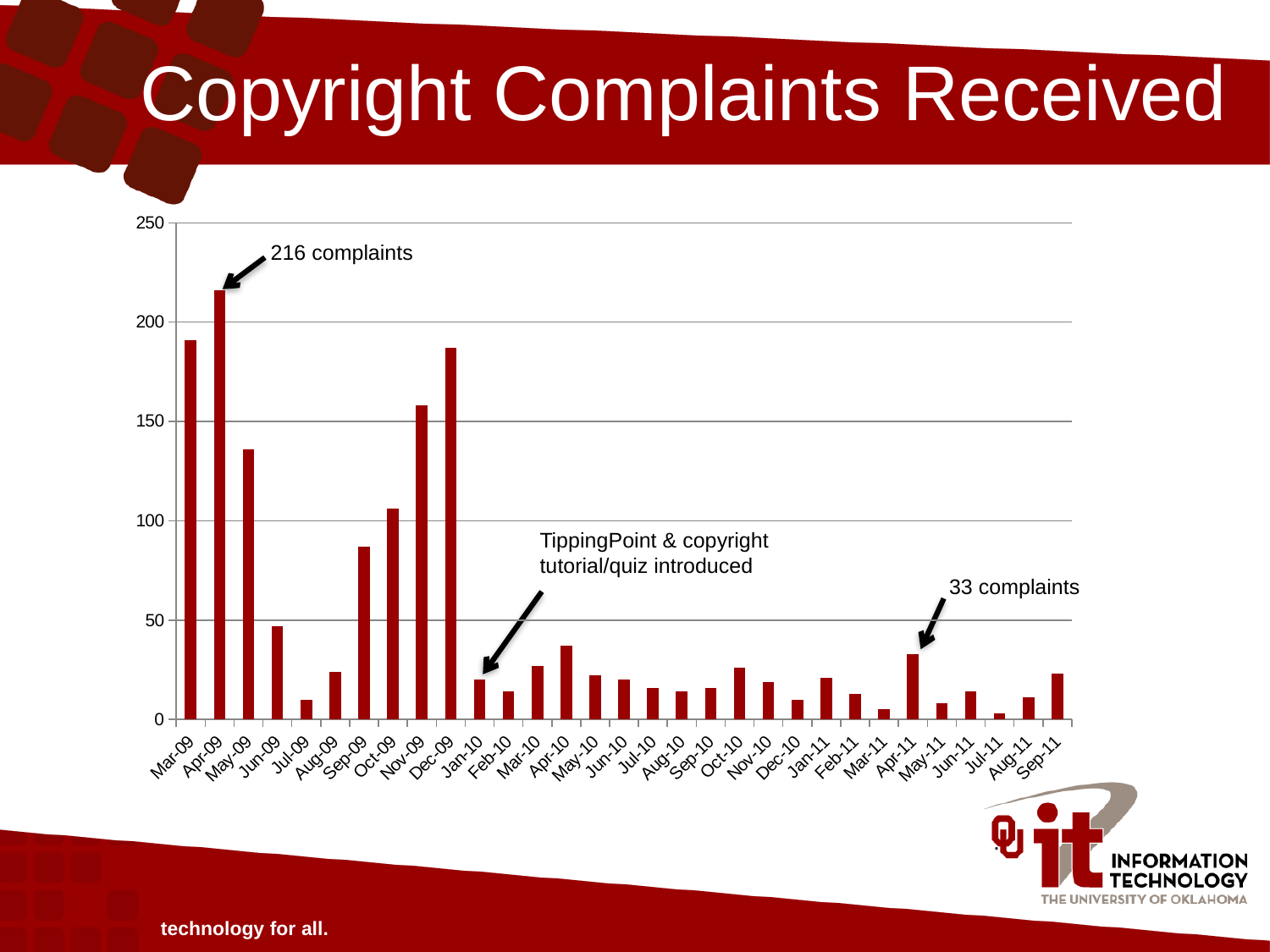
How many months are shown on the x axis? 31 Is the value for Jan-10 greater or less than 50? less Is the value for May-09 greater or less than 150? less What is the difference between the annotated Apr-09 value and the annotated Apr-11 value? 183 Which is larger, the value for Apr-09 or the value for Dec-09? Apr-09 What type of chart is shown on the slide? bar chart How many complaints were received in Apr-09, according to the annotation? 216 complaints What is the title of the chart? Copyright Complaints Received How many complaints were received in Apr-11, according to the annotation? 33 complaints What event does the annotation near Jan-10 say was introduced? TippingPoint & copyright tutorial/quiz introduced Is the value for Mar-09 greater or less than 150? greater Which month has the highest number of complaints? Apr-09